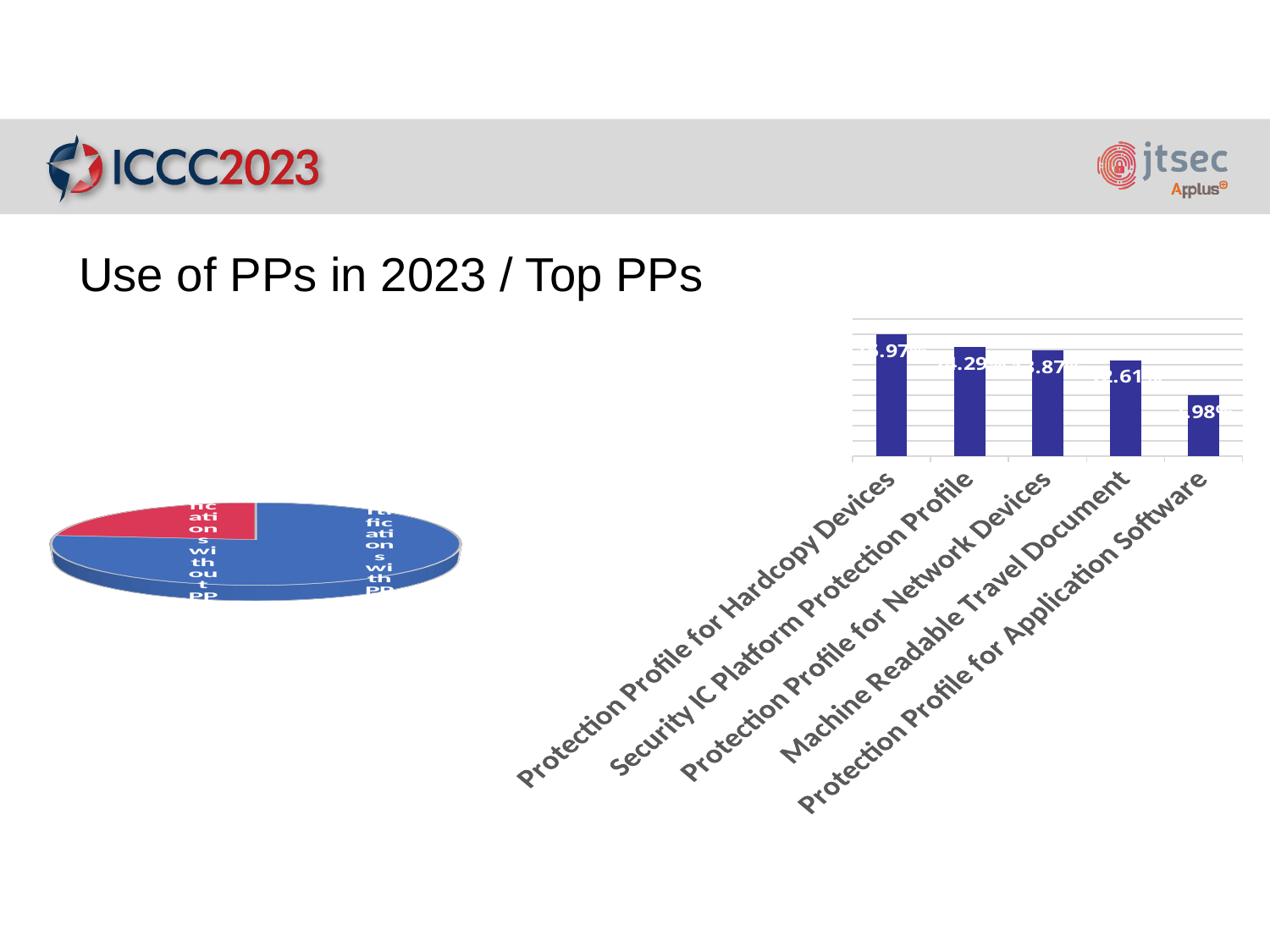
In the pie chart on the left, how many slices are there? 2 In the pie chart on the left, which colour is the larger slice? blue In the bar chart on the right, which is larger: the value for Protection Profile for Hardcopy Devices or the value for Protection Profile for Application Software? Protection Profile for Hardcopy Devices In the bar chart on the right, which is larger: the value for Protection Profile for Hardcopy Devices or the value for Machine Readable Travel Document? Protection Profile for Hardcopy Devices In the bar chart on the right, which is larger: the value for Machine Readable Travel Document or the value for Protection Profile for Application Software? Machine Readable Travel Document What kind of chart is shown on the right side of the slide? bar chart What kind of chart is shown on the left side of the slide? pie chart In the bar chart on the right, how many categories are plotted? 5 In the bar chart on the right, which category has the highest value? Protection Profile for Hardcopy Devices In the bar chart on the right, which category has the lowest value? Protection Profile for Application Software In the bar chart on the right, do the values rise or fall from left to right along the x axis? fall What is the title of the slide containing the charts? Use of PPs in 2023 / Top PPs